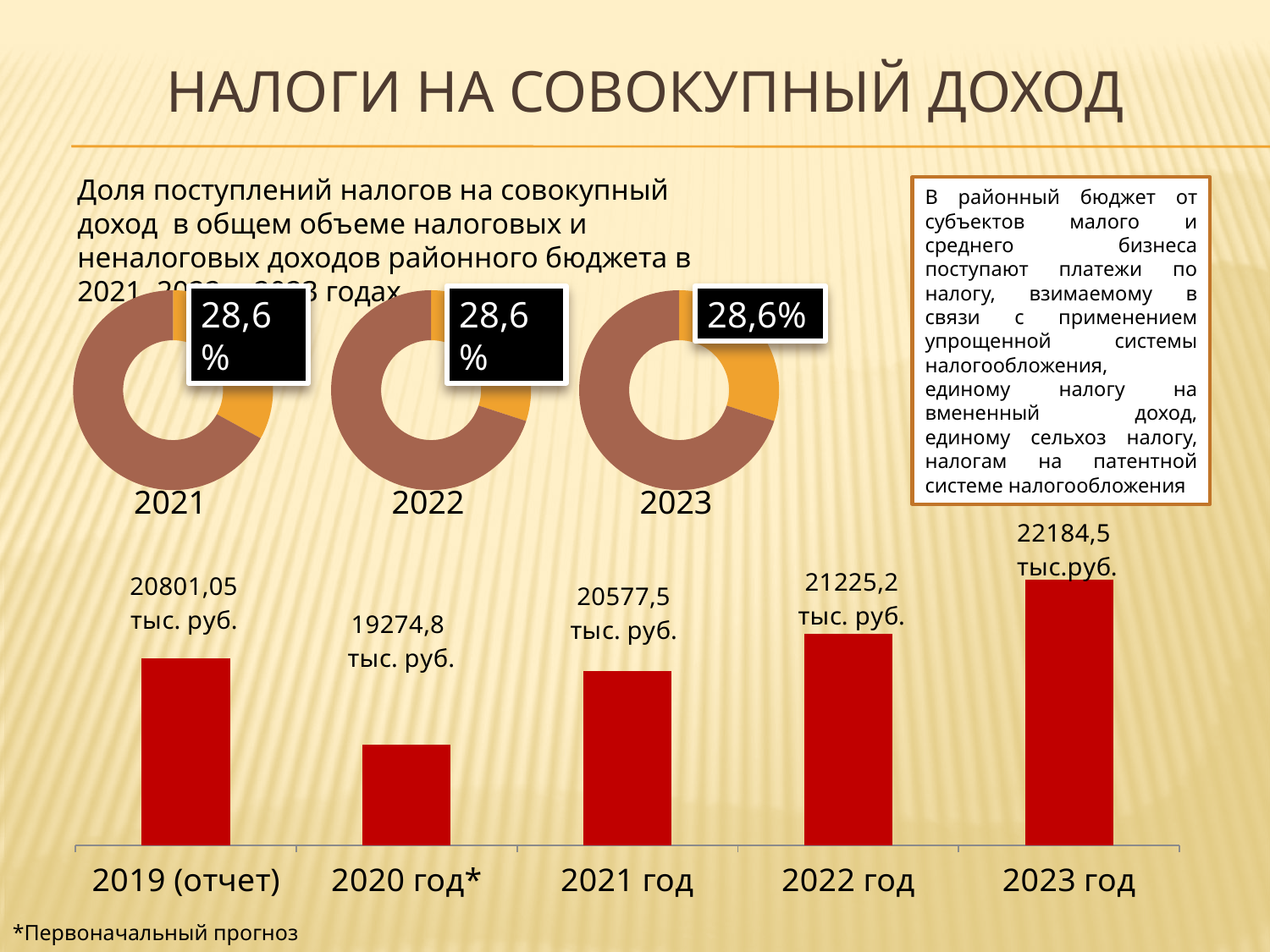
What percentage is labelled on the donut chart for 2022? 28,6% In the bar chart at the bottom of the slide, do the values rise or fall from 2020 год* to 2023 год? Rise In the bar chart at the bottom of the slide, what is the value for 2019 (отчет)? 20801,05 тыс. руб. How many donut charts are shown in the upper part of the slide? 3 In the bar chart at the bottom of the slide, which category has the highest value? 2023 год In the bar chart at the bottom of the slide, which category has the lowest value? 2020 год* How many categories are shown in the bar chart at the bottom of the slide? 5 What kind of chart is shown at the bottom of the slide? Bar chart In the bar chart at the bottom of the slide, what is the value for 2020 год*? 19274,8 тыс. руб. In the bar chart at the bottom of the slide, what is the difference between the values for 2023 год and 2022 год? 959,3 тыс. руб. In the bar chart at the bottom of the slide, what is the value for 2022 год? 21225,2 тыс. руб. In the bar chart at the bottom of the slide, which is larger: the value for 2019 (отчет) or the value for 2021 год? 2019 (отчет)